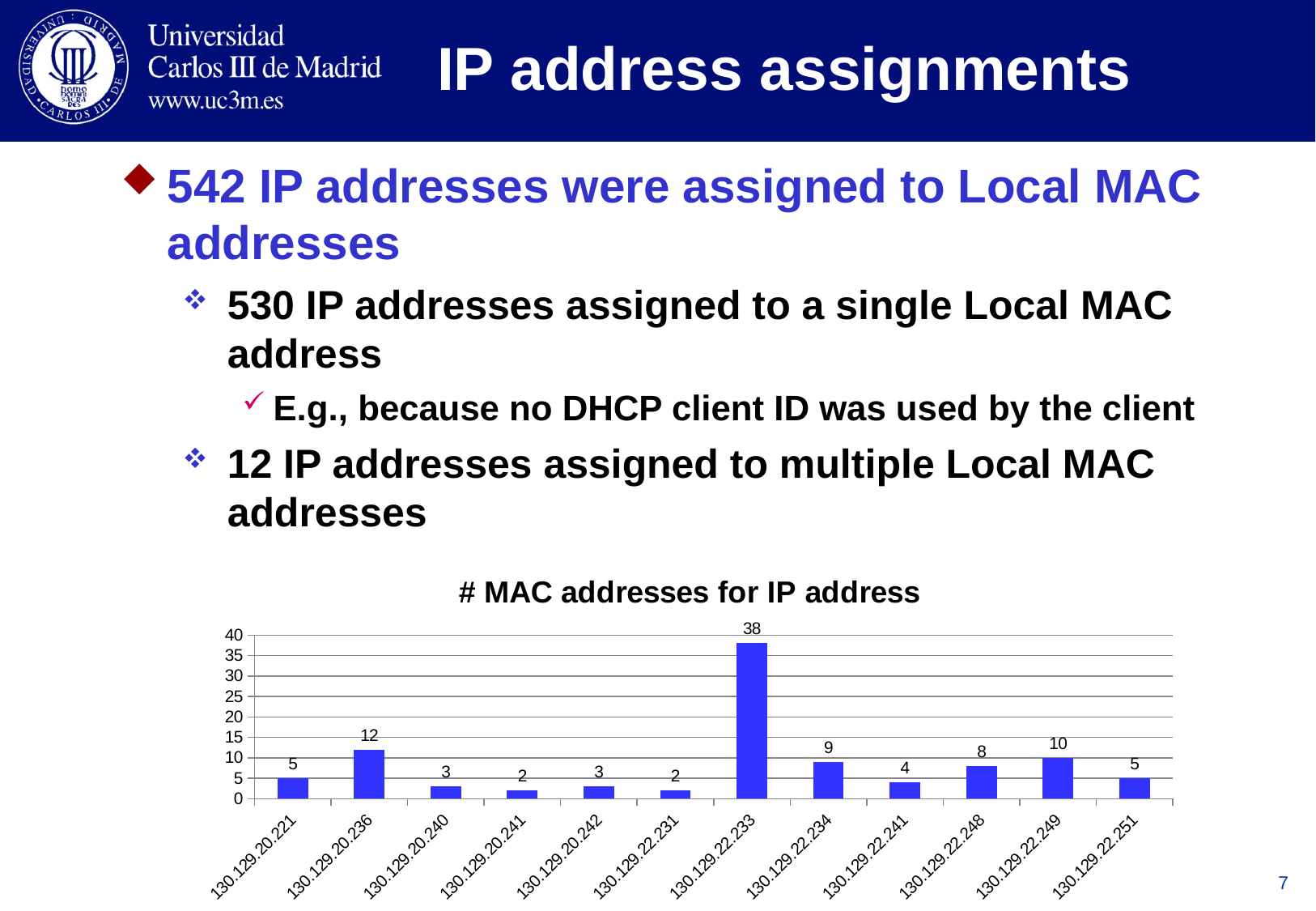
What is the difference between the number of MAC addresses for 130.129.22.249 and 130.129.22.251? 5 How many MAC addresses are shown for IP address 130.129.20.236? 12 What type of chart is shown on the slide? bar chart Which has more MAC addresses, 130.129.22.234 or 130.129.22.248? 130.129.22.234 How many MAC addresses are shown for IP address 130.129.22.249? 10 Is the value for 130.129.22.233 greater or less than 35? greater What is the title of the chart? # MAC addresses for IP address What is the difference between the number of MAC addresses for 130.129.22.233 and 130.129.20.236? 26 How many MAC addresses are shown for IP address 130.129.22.241? 4 How many IP addresses are shown on the x axis of the chart? 12 Which IP address has the highest number of MAC addresses? 130.129.22.233 How many MAC addresses are shown for IP address 130.129.22.233? 38